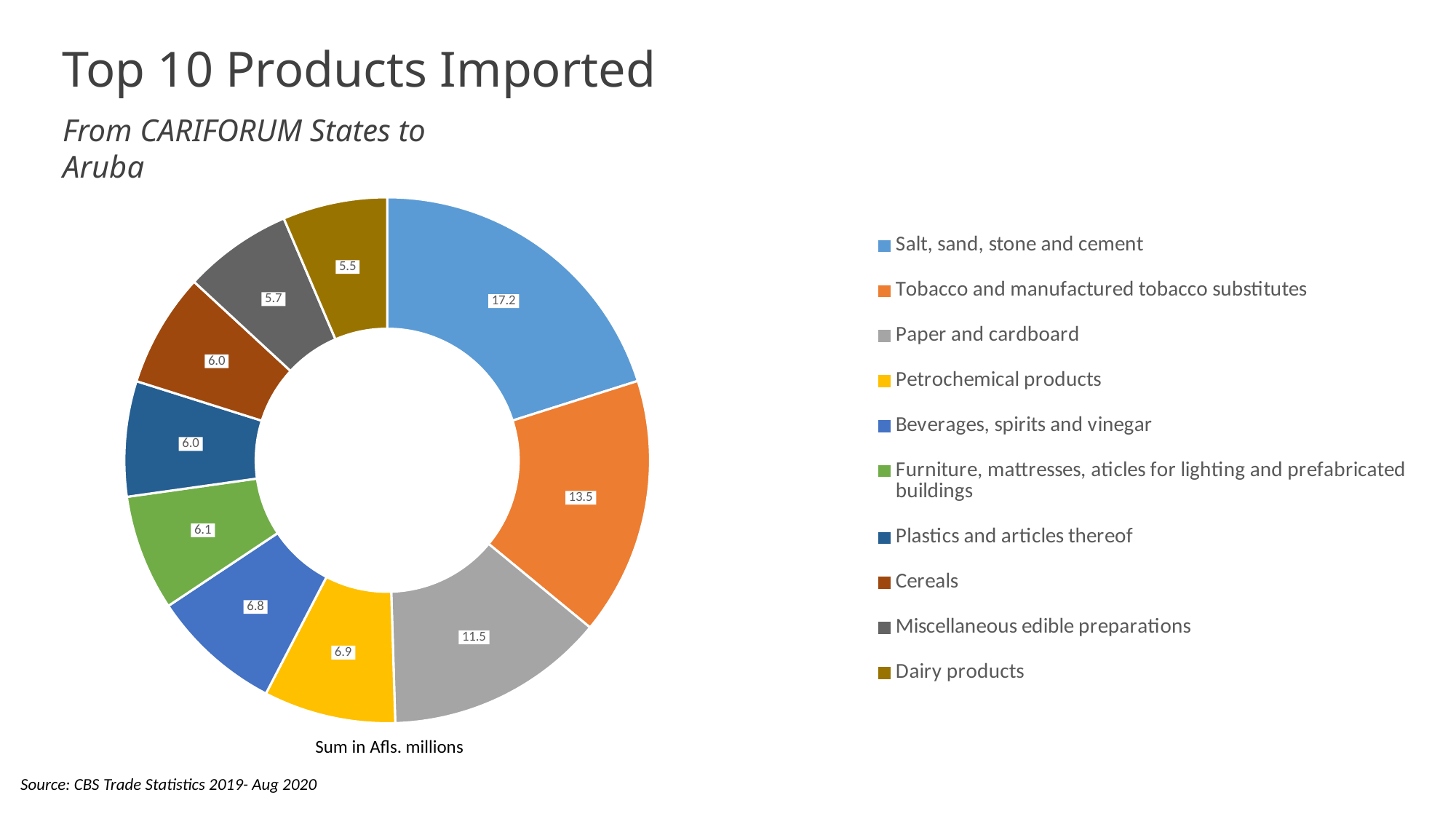
What is the value for Paper and cardboard? 11.5 What is the value for Salt, sand, stone and cement? 17.2 Which product category has the highest value? Salt, sand, stone and cement Which product category has the lowest value? Dairy products What is the value for Tobacco and manufactured tobacco substitutes? 13.5 What unit is stated below the chart? Sum in Afls. millions How many product categories are shown in the chart? 10 What is the value for Miscellaneous edible preparations? 5.7 What is the difference between the values for Salt, sand, stone and cement and Tobacco and manufactured tobacco substitutes? 3.7 What kind of chart is shown on the slide? doughnut chart Which is larger, the value for Petrochemical products or the value for Cereals? Petrochemical products What is the value for Dairy products? 5.5